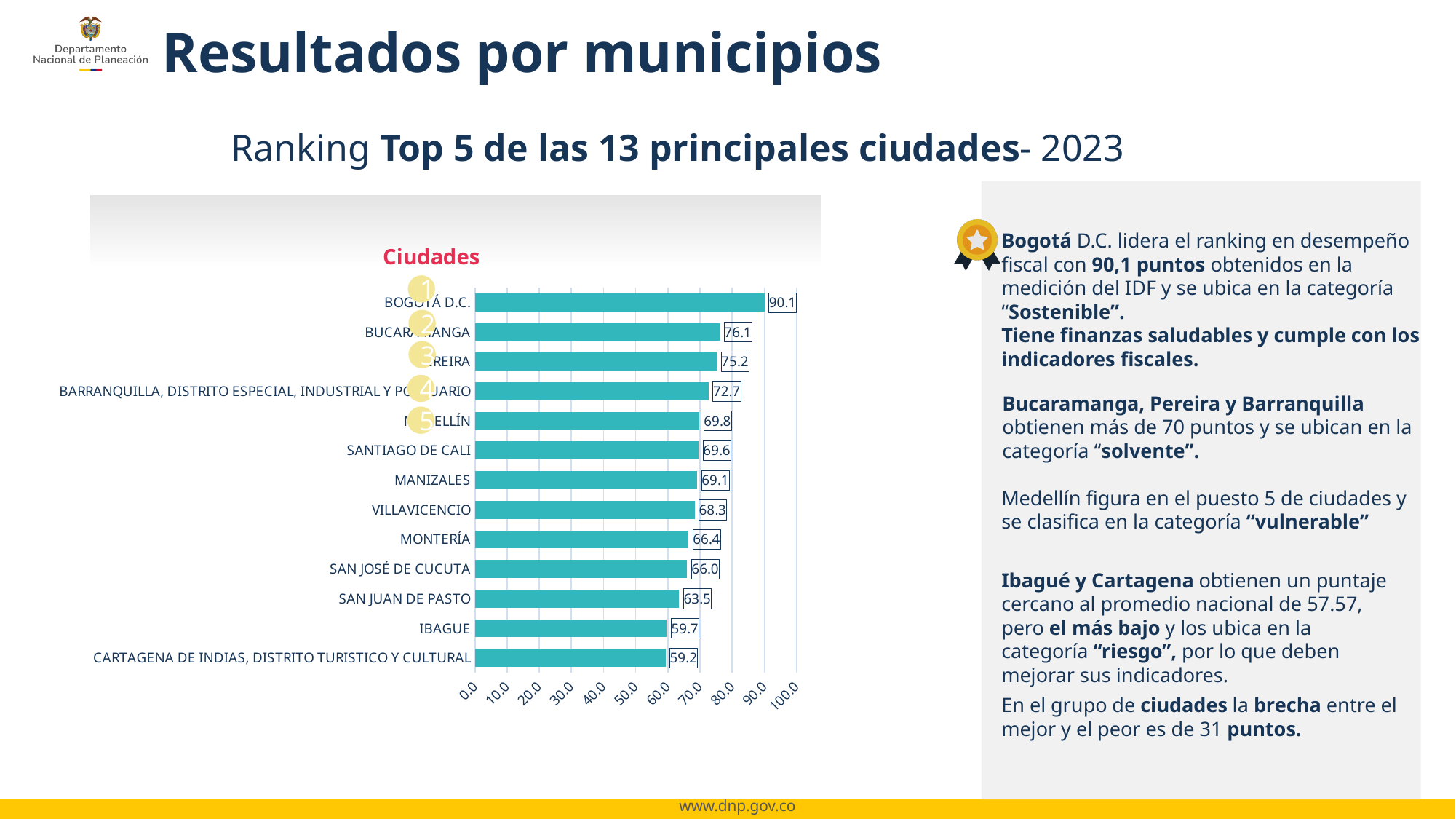
What is the value for SAN JUAN DE PASTO in the Ciudades chart? 63.5 What is the value for BOGOTÁ D.C. in the Ciudades chart? 90.1 What is the value for MANIZALES in the Ciudades chart? 69.1 Which has a larger value in the Ciudades chart, MONTERÍA or SAN JUAN DE PASTO? MONTERÍA What is the title of the chart on the slide? Ciudades What kind of chart is the Ciudades chart? bar chart Which city has the highest value in the Ciudades chart? BOGOTÁ D.C. Which city has the lowest value in the Ciudades chart? CARTAGENA DE INDIAS, DISTRITO TURISTICO Y CULTURAL What is the difference between the values for BOGOTÁ D.C. and IBAGUE in the Ciudades chart? 30.4 Is the value for SANTIAGO DE CALI in the Ciudades chart greater or less than 60.0? greater What is the value for VILLAVICENCIO in the Ciudades chart? 68.3 How many cities are shown in the Ciudades chart? 13